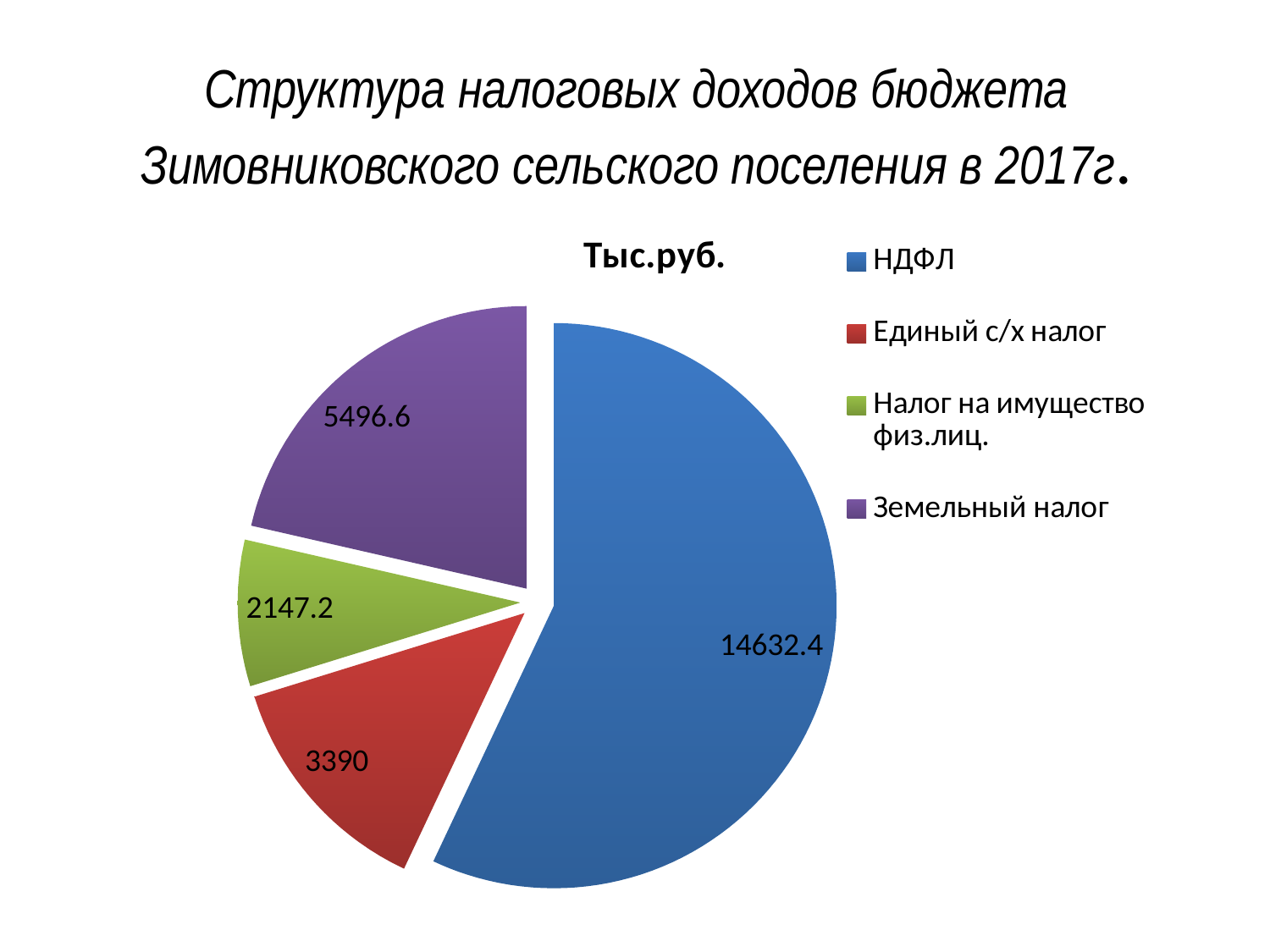
What is the difference between the values for НДФЛ and Земельный налог? 9135.8 Which category has the largest slice in the pie chart? НДФЛ What is the value for Земельный налог in the pie chart? 5496.6 Which category has the smallest slice in the pie chart? Налог на имущество физ.лиц. What is the difference between the values for Земельный налог and Единый с/х налог? 2106.6 What is the value for НДФЛ in the pie chart? 14632.4 Which is larger, the value for Единый с/х налог or the value for Налог на имущество физ.лиц.? Единый с/х налог What is the value for Единый с/х налог in the pie chart? 3390 What is the title shown above the pie chart? Тыс.руб. What is the value for Налог на имущество физ.лиц. in the pie chart? 2147.2 How many categories does the pie chart show? 4 What kind of chart is shown on the slide? Pie chart